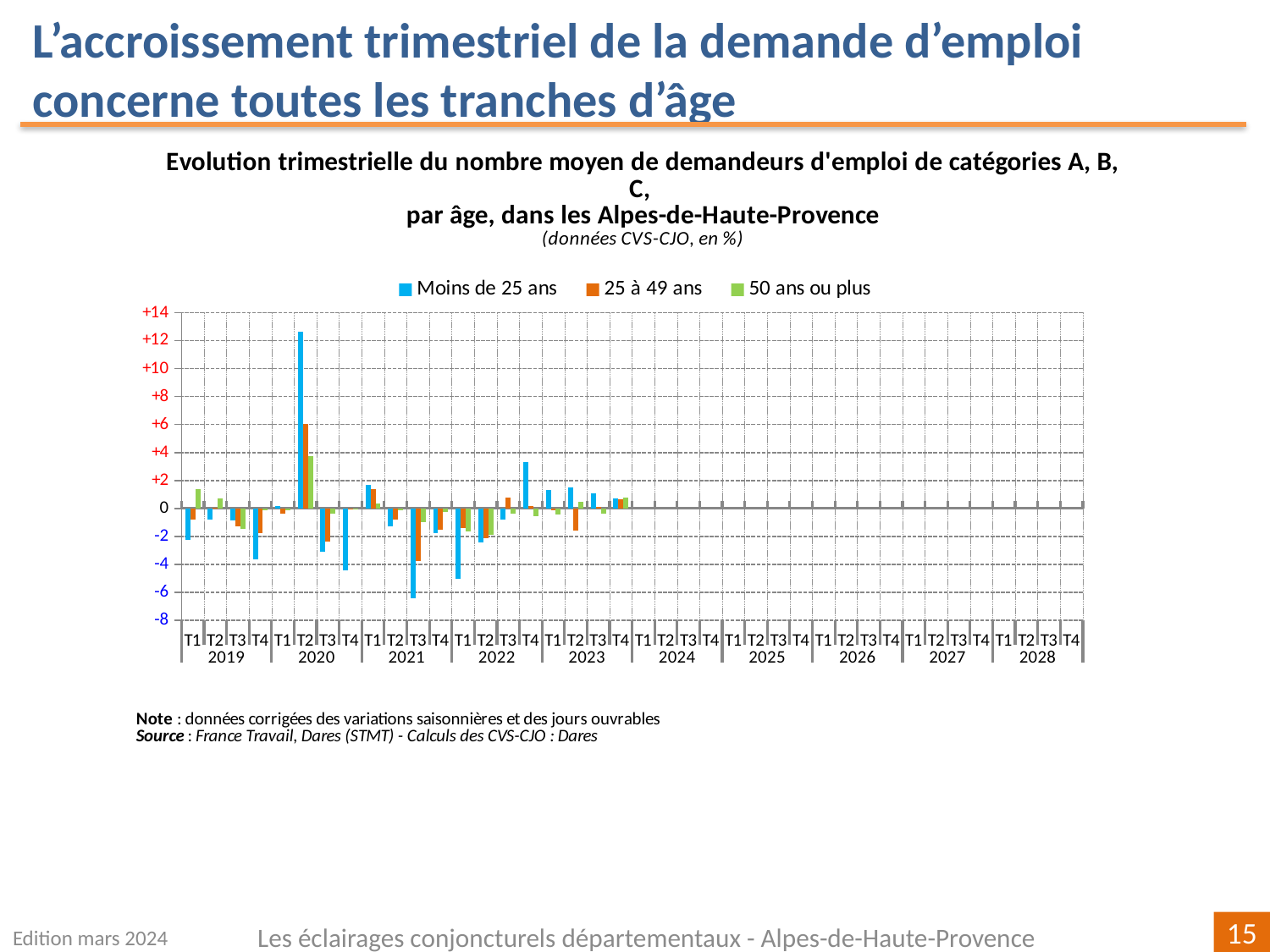
Which series and quarter has the highest value in the chart? Moins de 25 ans, T2 2020 Which series has the lowest value in the chart, and in which quarter? Moins de 25 ans, T3 2021 Is the value for Moins de 25 ans in T2 2020 greater or less than +10? greater What kind of chart is shown on the slide? bar chart What is the highest value shown on the y axis? +14 Is the value for Moins de 25 ans in T4 2022 greater or less than +2? greater In T2 2020, which series has the larger value: Moins de 25 ans or 25 à 49 ans? Moins de 25 ans Is the value for Moins de 25 ans in T3 2021 greater or less than -4? less Which series are listed in the legend? Moins de 25 ans, 25 à 49 ans, 50 ans ou plus How many series does the legend list? 3 How many years are labelled on the x axis? 10